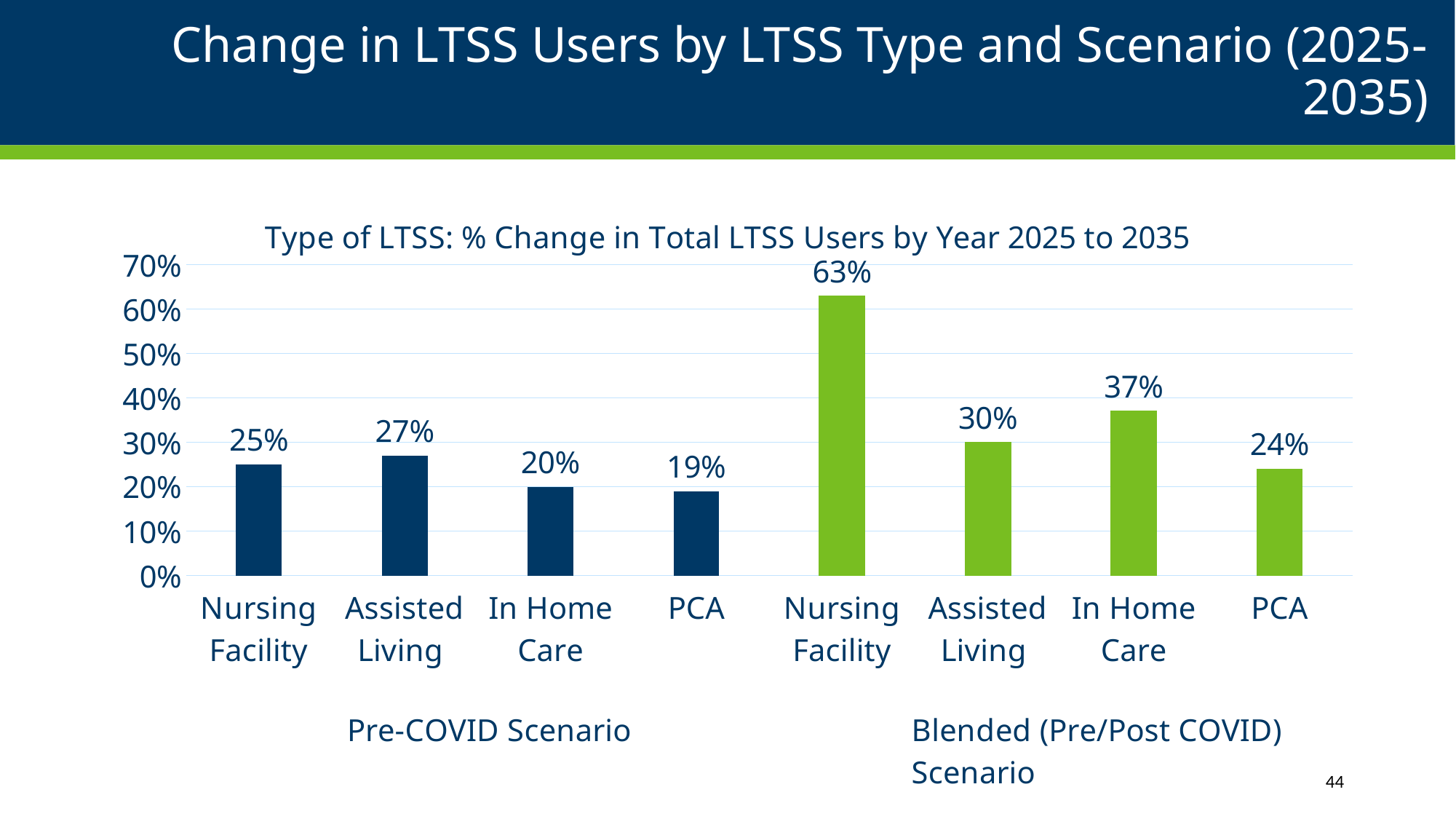
What is the value for PCA in the Pre-COVID Scenario? 19% Which is larger: Assisted Living in the Pre-COVID Scenario or Assisted Living in the Blended Scenario? Assisted Living in the Blended Scenario What is the value for Nursing Facility in the Pre-COVID Scenario? 25% Is the value for In Home Care in the Pre-COVID Scenario greater or less than 30%? less Which bar has the highest value on the chart? Nursing Facility (Blended Scenario) What type of chart is shown on the slide? Bar chart What is the value for In Home Care in the Blended (Pre/Post COVID) Scenario? 37% What colour are the bars for the Blended (Pre/Post COVID) Scenario? Green Which bar has the lowest value on the chart? PCA (Pre-COVID Scenario) What is the difference between the Nursing Facility values in the Blended Scenario and the Pre-COVID Scenario? 38 percentage points How many bars are plotted on the chart? 8 What is the chart's title? Type of LTSS: % Change in Total LTSS Users by Year 2025 to 2035